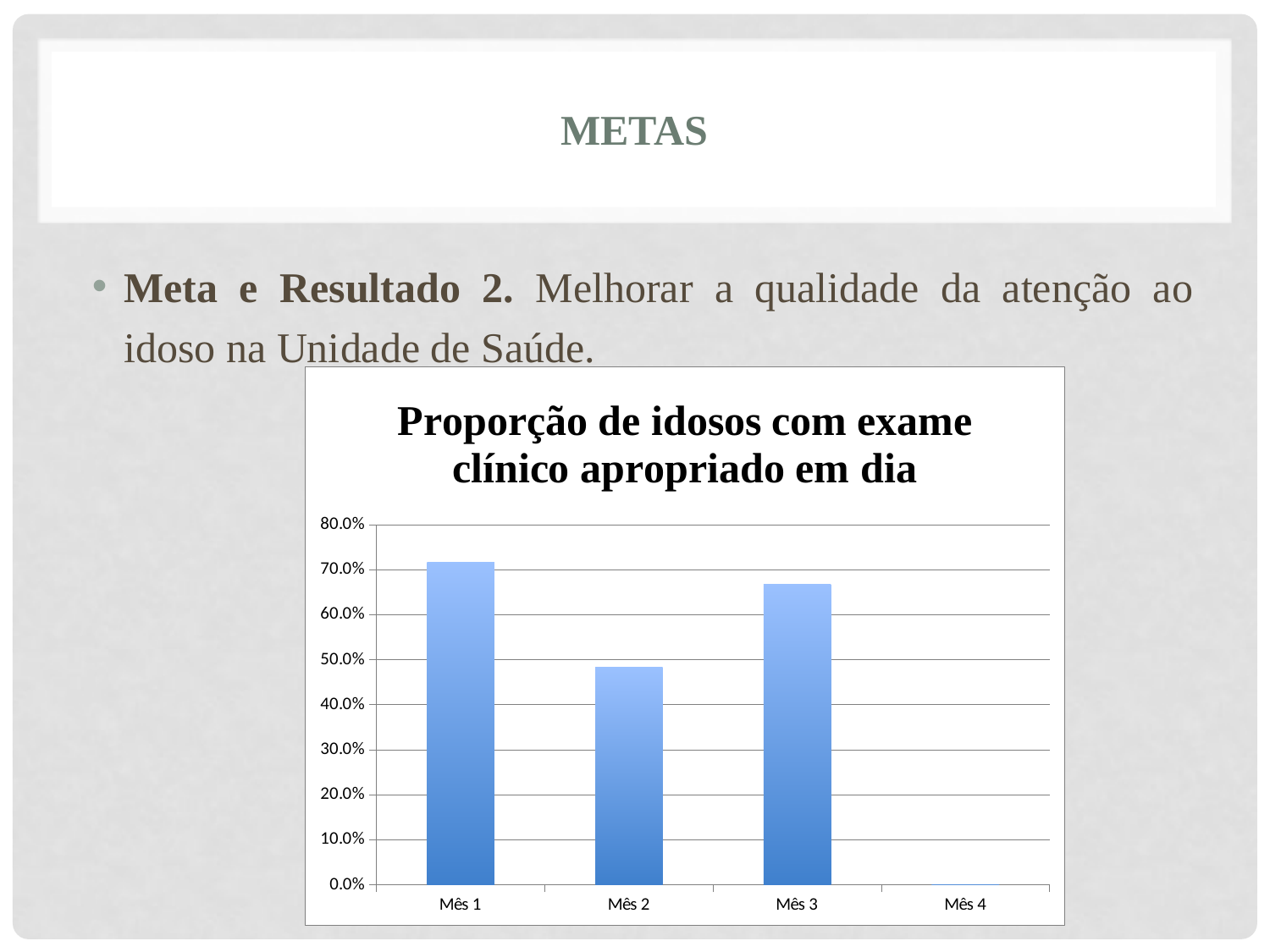
Is the value for Mês 1 greater or less than 60.0%? greater What is the title of the chart? Proporção de idosos com exame clínico apropriado em dia Is the value for Mês 2 greater or less than 40.0%? greater Which month category has no visible bar in the chart? Mês 4 What is the highest value shown on the y axis of the chart? 80.0% Is the value for Mês 3 greater or less than 70.0%? less What kind of chart is shown on the slide? bar chart Which month has the highest bar in the chart? Mês 1 Which of Mês 1 and Mês 3 has the larger value? Mês 1 Which of Mês 2 and Mês 3 has the larger value? Mês 3 How many month categories are shown on the x axis of the chart? 4